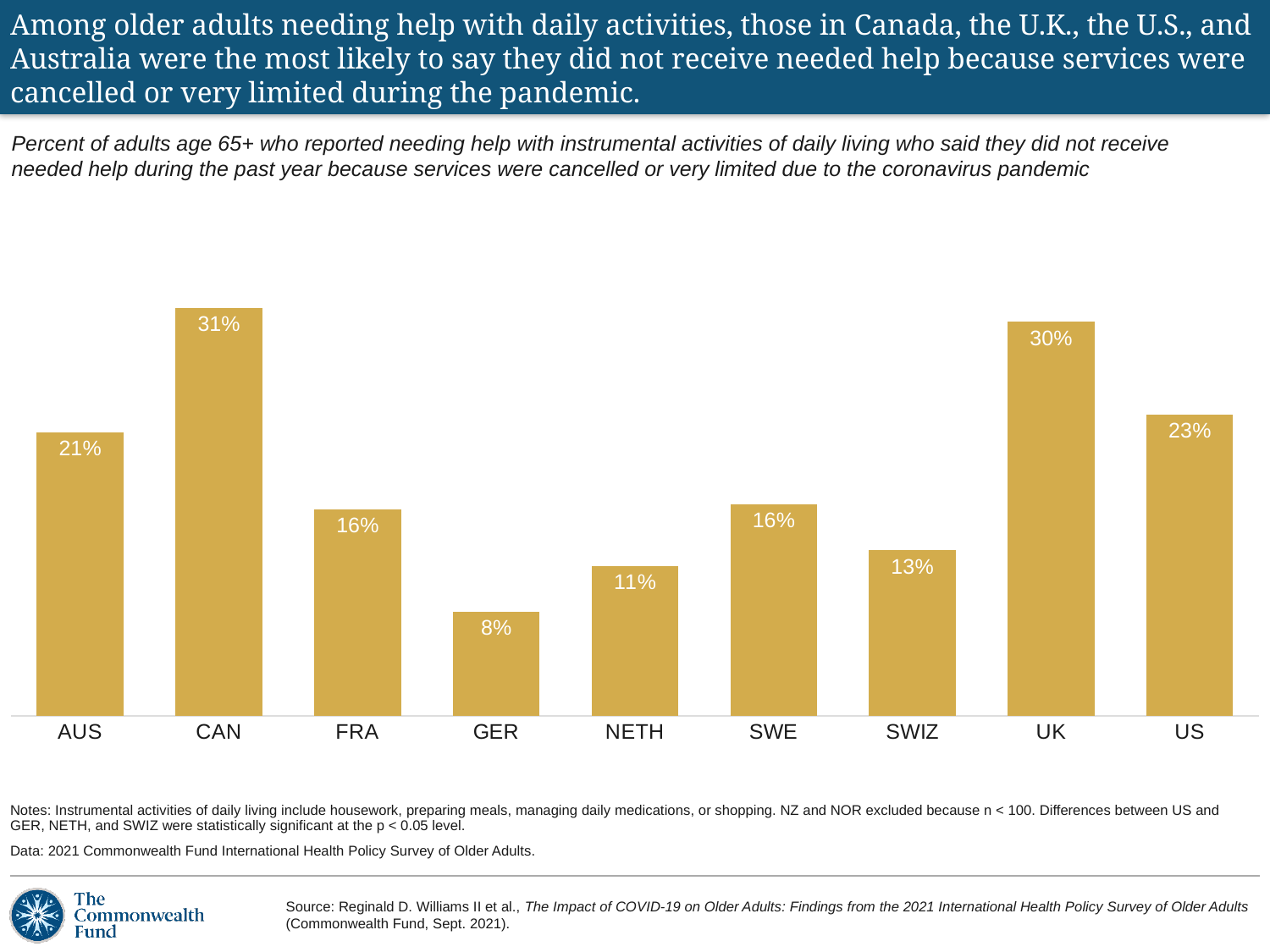
What is the value for CAN? 31% Which two countries share the same value of 16%? FRA and SWE What is the difference between the values for CAN and US? 8 percentage points What is the value for SWIZ? 13% What is the value for GER? 8% Which is larger, the value for AUS or the value for SWE? AUS Which country has the lowest value? GER What is the difference between the values for UK and NETH? 19 percentage points How many countries are shown in the chart? 9 Which country has the highest value? CAN What is the value for US? 23% What kind of chart is shown on the slide? Bar chart